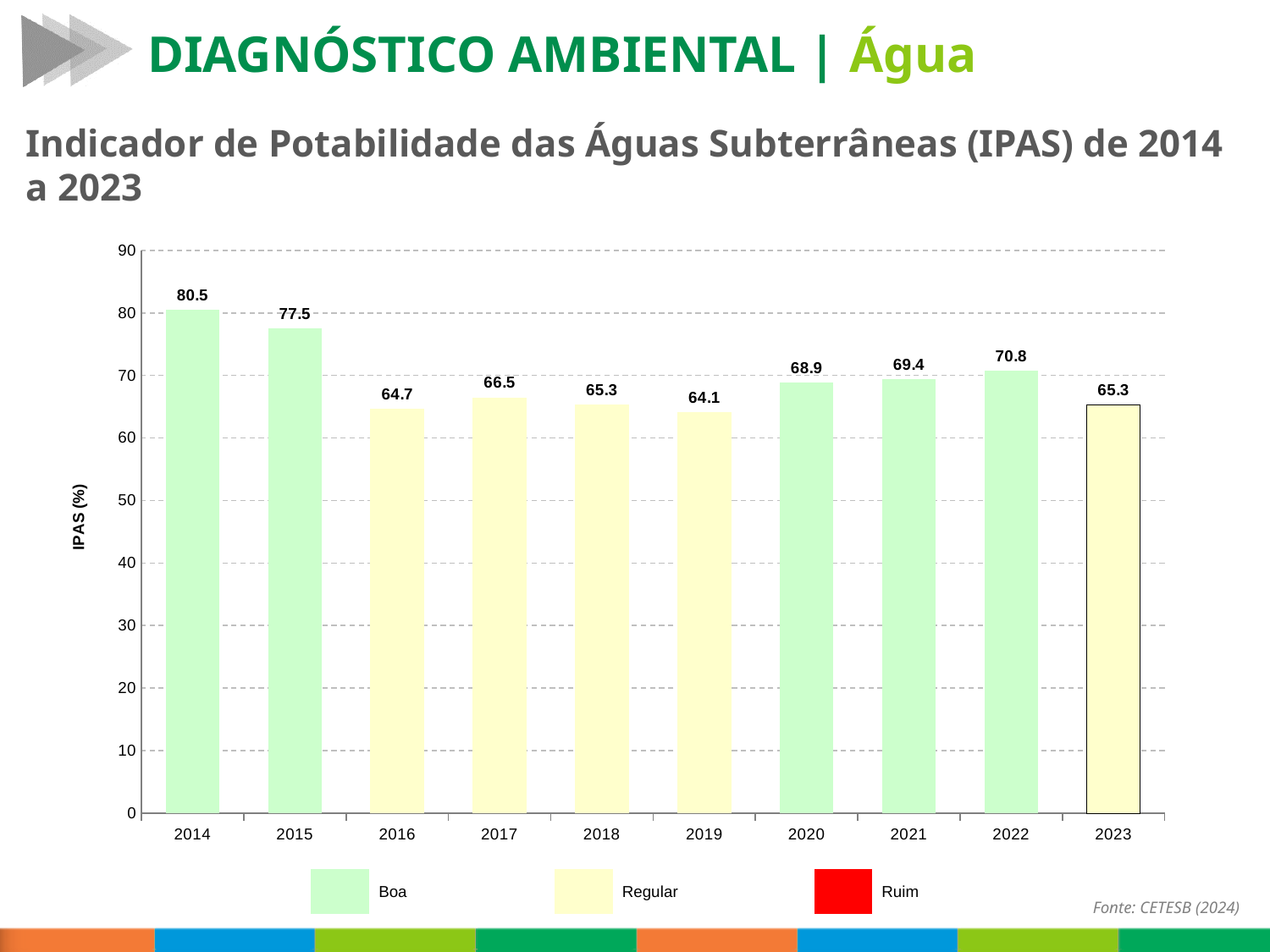
What is the IPAS value for 2023? 65.3 Which year has the lowest IPAS value? 2019 What is the IPAS value for 2014? 80.5 Is the IPAS value for 2016 greater or less than 70? less What is the difference between the IPAS values for 2014 and 2015? 3.0 What is the difference between the IPAS values for 2022 and 2023? 5.5 How many categories does the legend list? 3 Which year has a larger IPAS value, 2020 or 2017? 2020 Which year has the highest IPAS value? 2014 How many years are shown on the x axis? 10 What kind of chart is shown on the slide? bar chart What is the IPAS value for 2019? 64.1